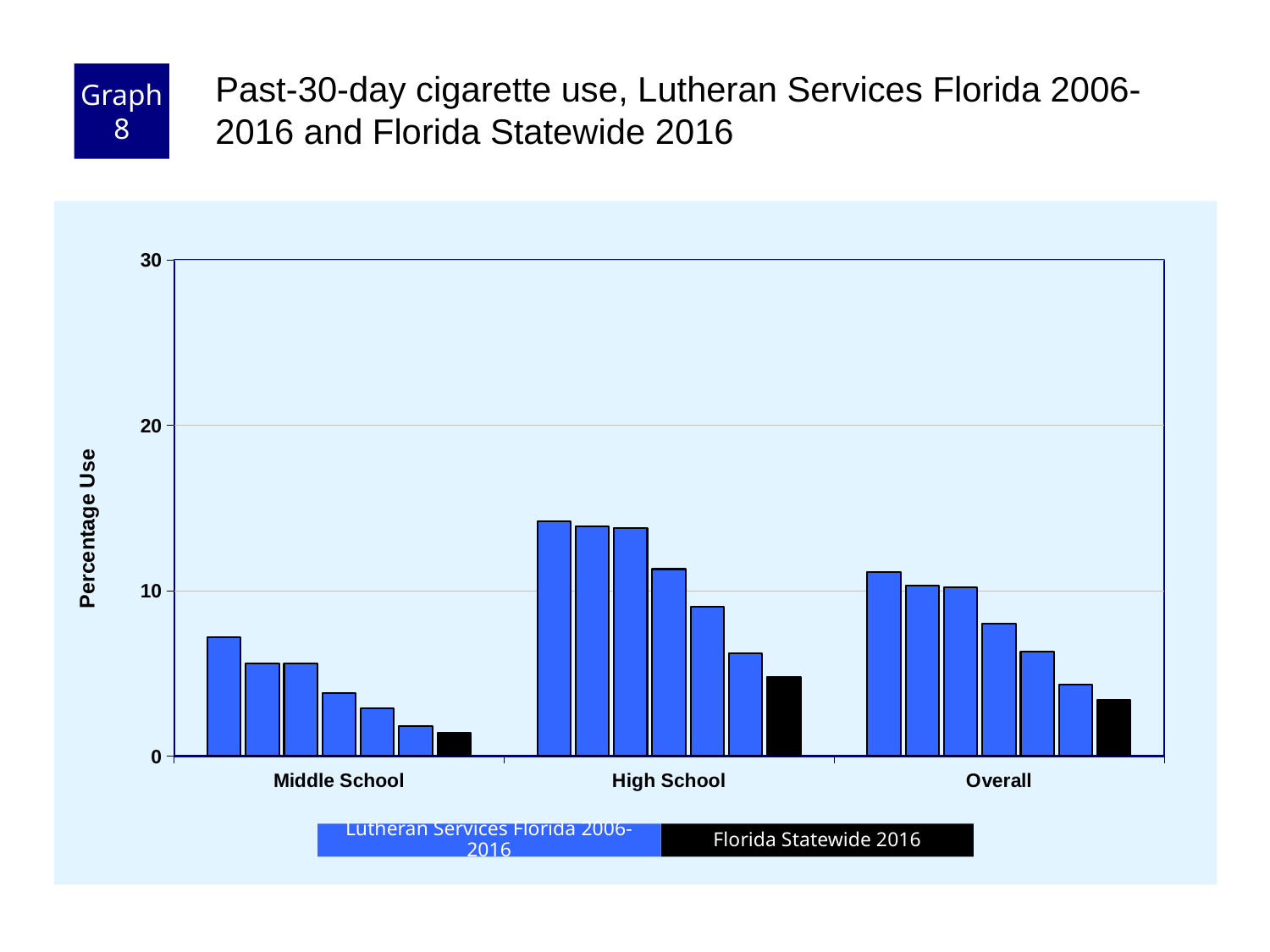
Is the tallest Lutheran Services Florida bar for High School greater or less than 20? less Which category has the lowest bars overall? Middle School Which series is shown in black in the legend? Florida Statewide 2016 Which is larger, the Florida Statewide 2016 value for High School or for Middle School? High School How many series does the legend list? 2 Is the tallest Lutheran Services Florida bar for High School greater or less than 10? greater How many categories are shown on the x axis? 3 What kind of chart is shown on the slide? bar chart Is the Florida Statewide 2016 value for High School greater or less than 10? less Which category has the highest bars overall? High School What is the label of the y axis? Percentage Use